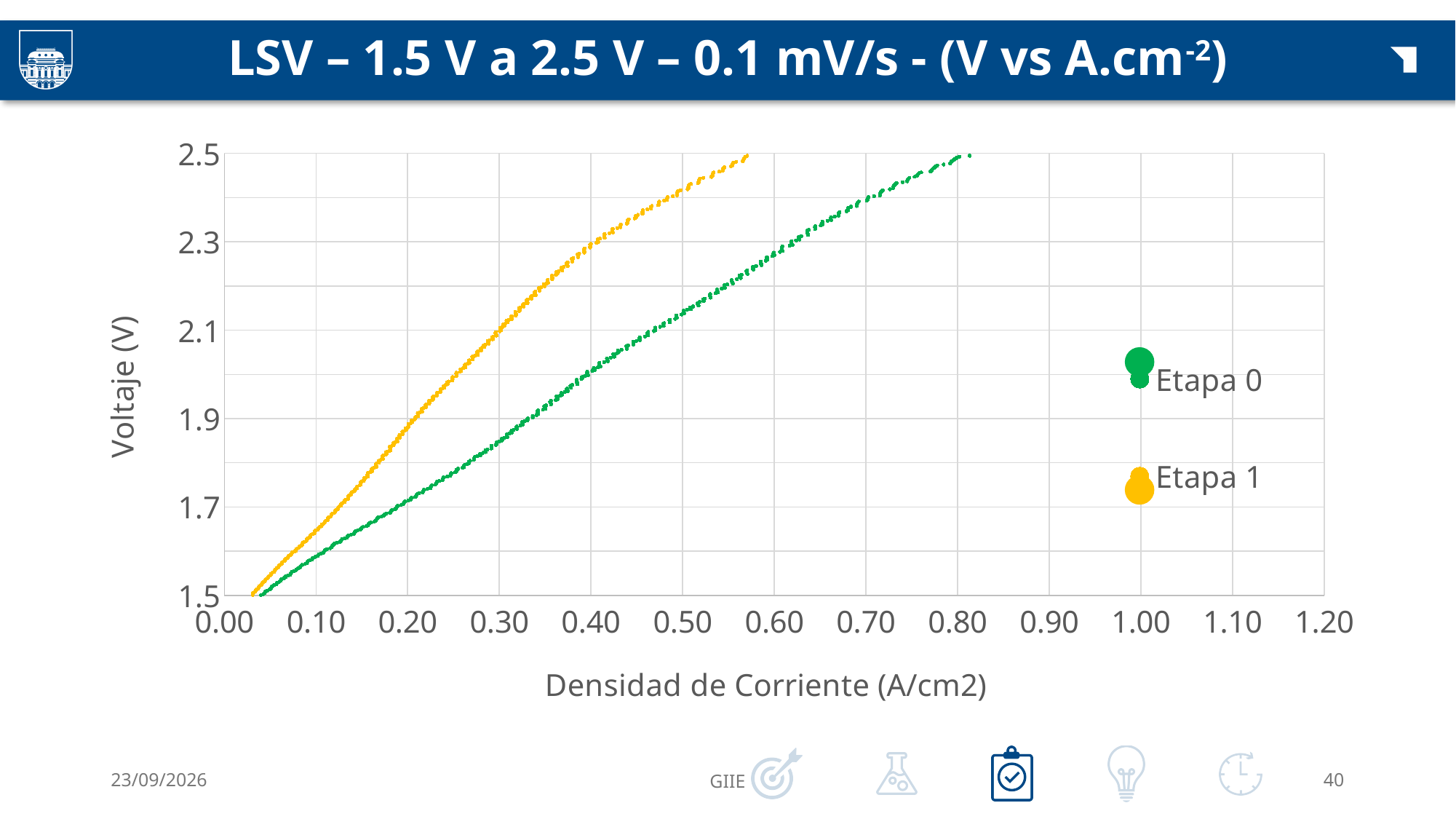
Is the current density of Etapa 0 at 2.1 V greater or less than 0.40 A/cm2? greater How many series does the legend list? 2 Does the voltage rise or fall as current density increases for the Etapa 1 series? Rises Is the maximum current density reached by Etapa 0 greater or less than 0.70 A/cm2? greater Is the current density of Etapa 1 at 2.1 V greater or less than 0.40 A/cm2? less What are the names of the two series in the legend? Etapa 0 and Etapa 1 Which series reaches a higher current density at 2.5 V, Etapa 0 or Etapa 1? Etapa 0 At a current density of 0.40 A/cm2, which series shows the higher voltage, Etapa 0 or Etapa 1? Etapa 1 Does the voltage rise or fall as current density increases for the Etapa 0 series? Rises What kind of chart is shown on the slide? Scatter chart What is the title of the x axis? Densidad de Corriente (A/cm2)